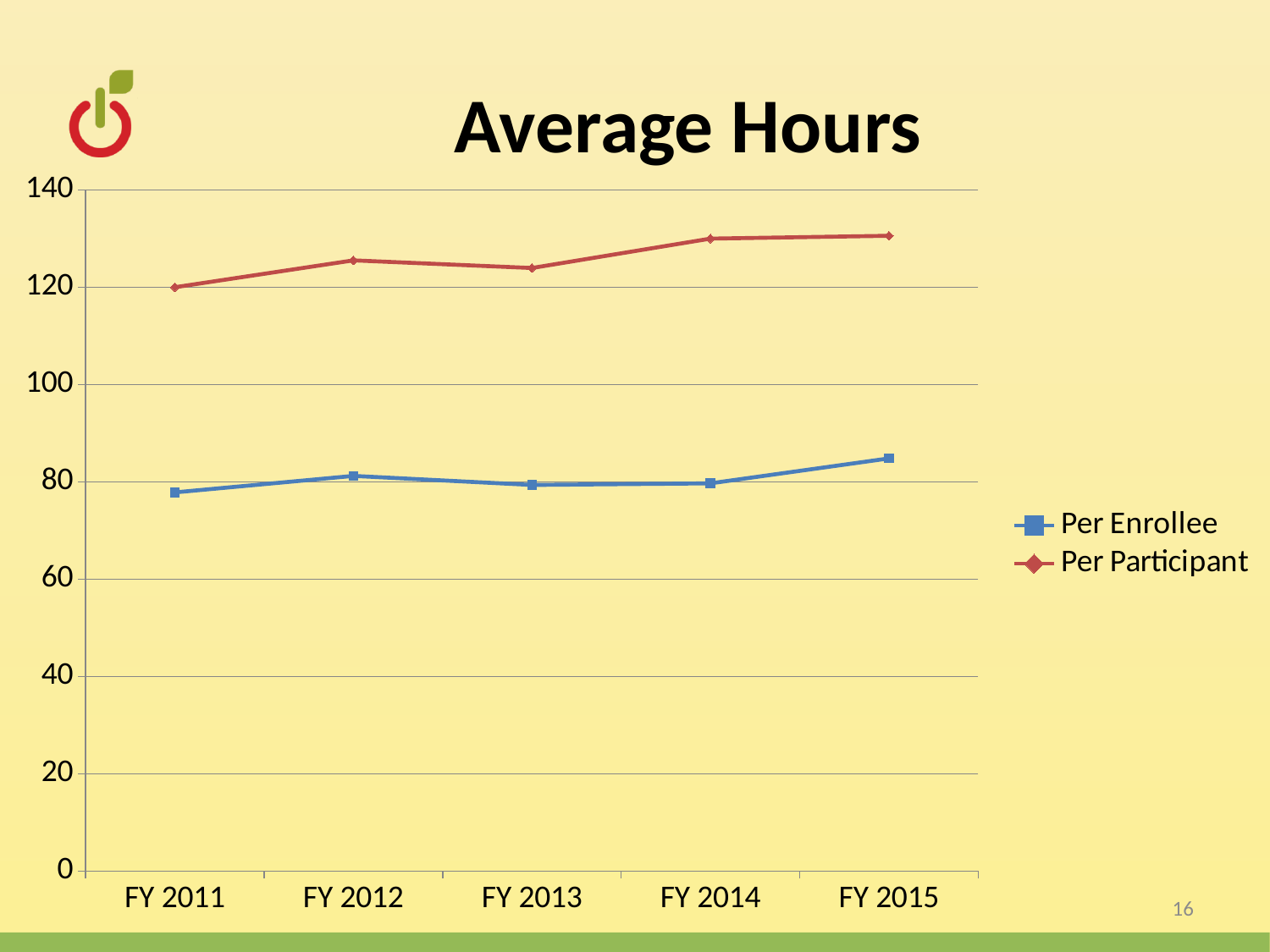
What kind of chart is shown on the slide? line chart Is the value for Per Enrollee in FY 2011 greater or less than 80? less In which fiscal year is the Per Participant value lowest? FY 2011 In FY 2013, which series has the larger value, Per Enrollee or Per Participant? Per Participant In which fiscal year is the Per Enrollee value highest? FY 2015 Is the value for Per Participant in FY 2012 greater or less than 140? less Which series is drawn in blue? Per Enrollee What is the title of the chart? Average Hours How many series does the legend list? 2 How many fiscal years are plotted along the x axis? 5 Is the value for Per Participant in FY 2014 greater or less than 120? greater